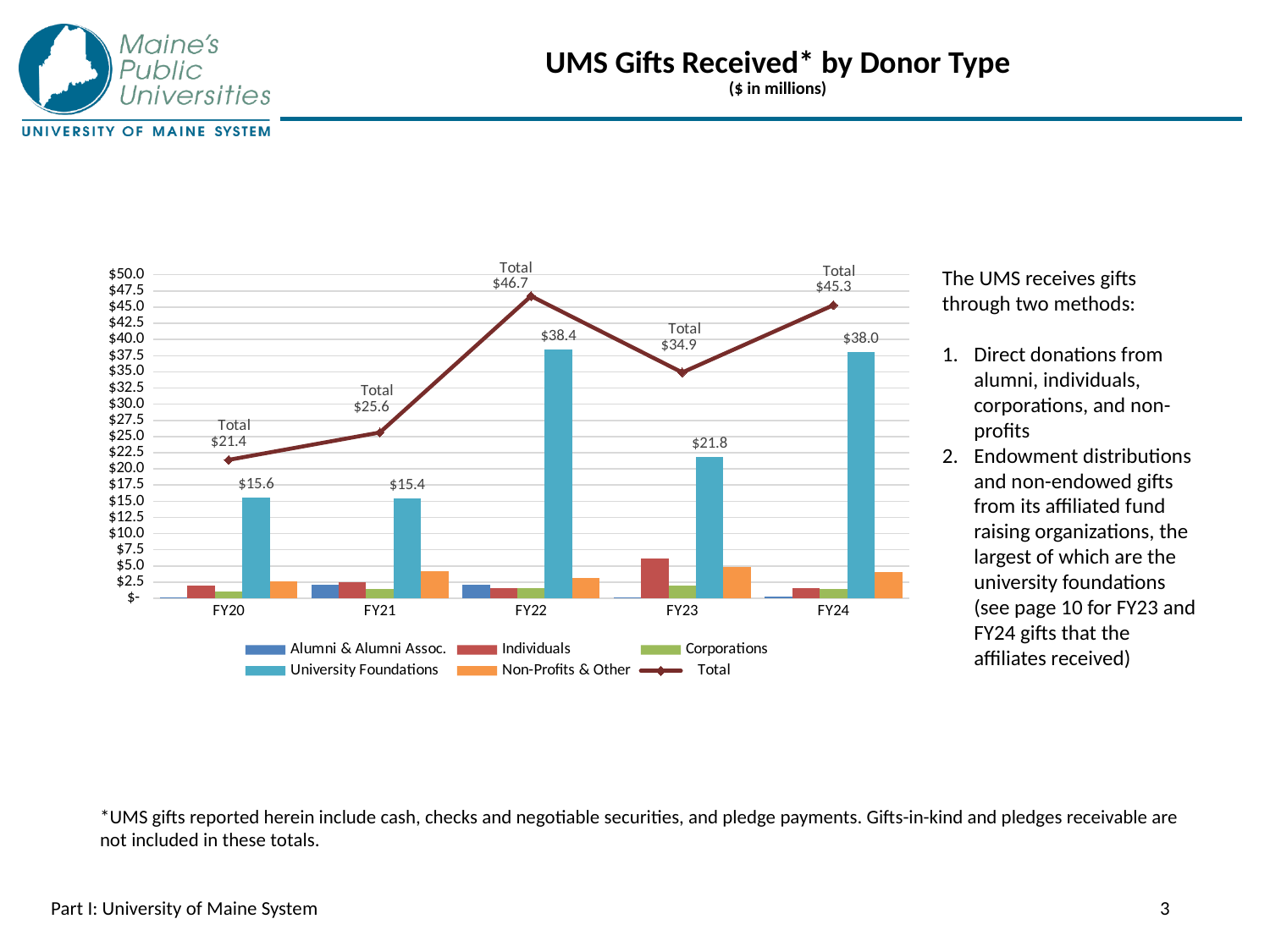
How many fiscal years are shown on the x axis? 5 Is the Individuals value for FY23 greater or less than $5.0? greater What unit is stated under the chart title? $ in millions What is the University Foundations value for FY23? $21.8 Which is larger, the University Foundations value for FY22 or for FY24? FY22 Which fiscal year has the highest Total? FY22 How many series does the legend list? 6 What is the difference between the Total for FY22 and the Total for FY23? $11.8 Does the Total rise or fall from FY20 to FY22? rise Which fiscal year has the lowest Total? FY20 What is the University Foundations value for FY20? $15.6 What is the Total value for FY22? $46.7